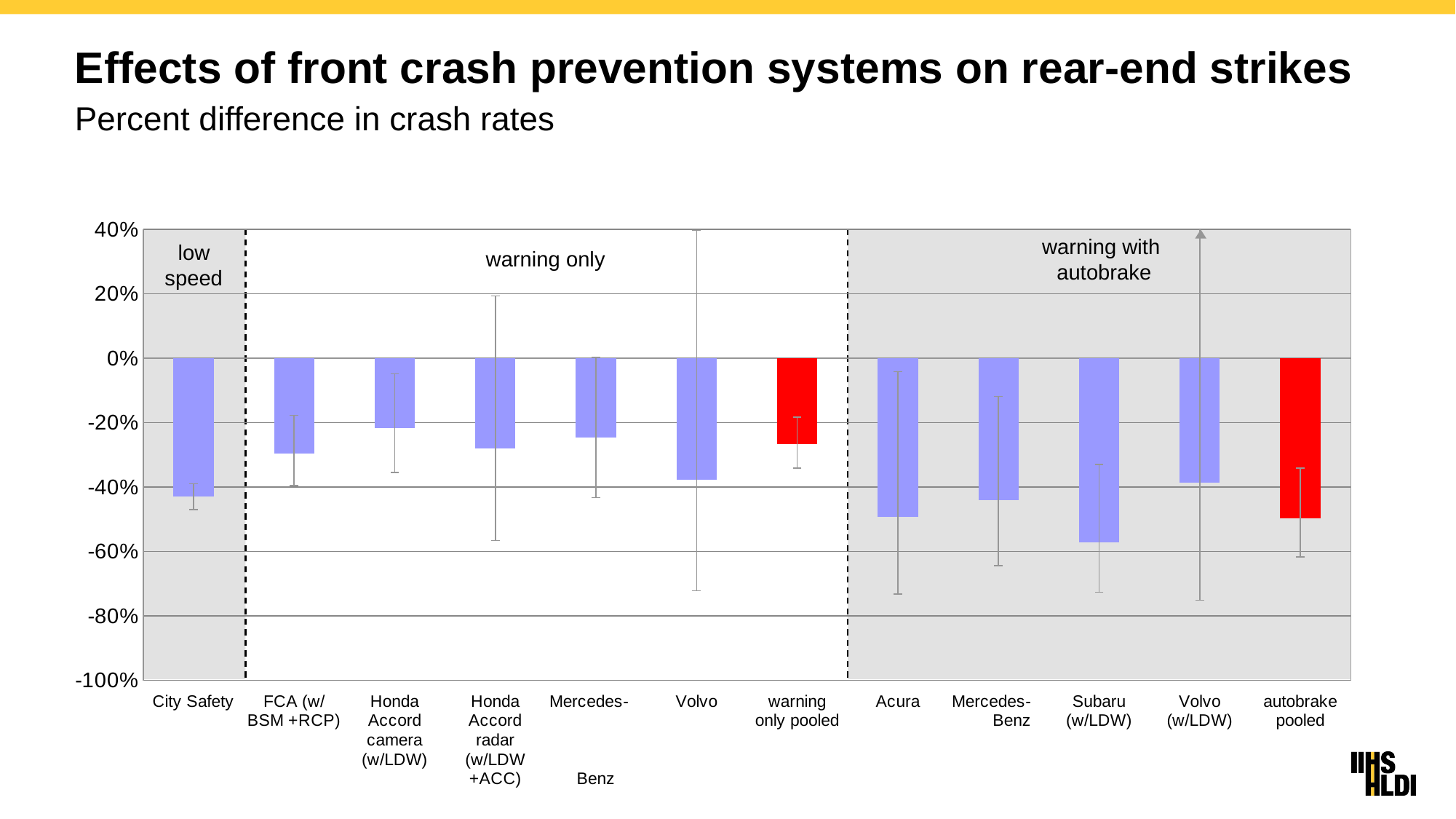
What are the three group labels shown across the top of the chart? low speed, warning only, warning with autobrake Is the value for Subaru (w/LDW) greater or less than -40%? less What kind of chart is shown on the slide? bar chart Which has the lower value, Acura or FCA (w/ BSM +RCP)? Acura How many bars (categories) are plotted in the chart? 12 Is the value for Mercedes-Benz in the warning only group greater or less than -40%? greater Is the value for City Safety greater or less than -40%? less Which has the lower value, Subaru (w/LDW) or Honda Accord camera (w/LDW)? Subaru (w/LDW) Which category has the lowest (most negative) value in the chart? Subaru (w/LDW) Which category has the highest (least negative) value in the chart? Honda Accord camera (w/LDW)